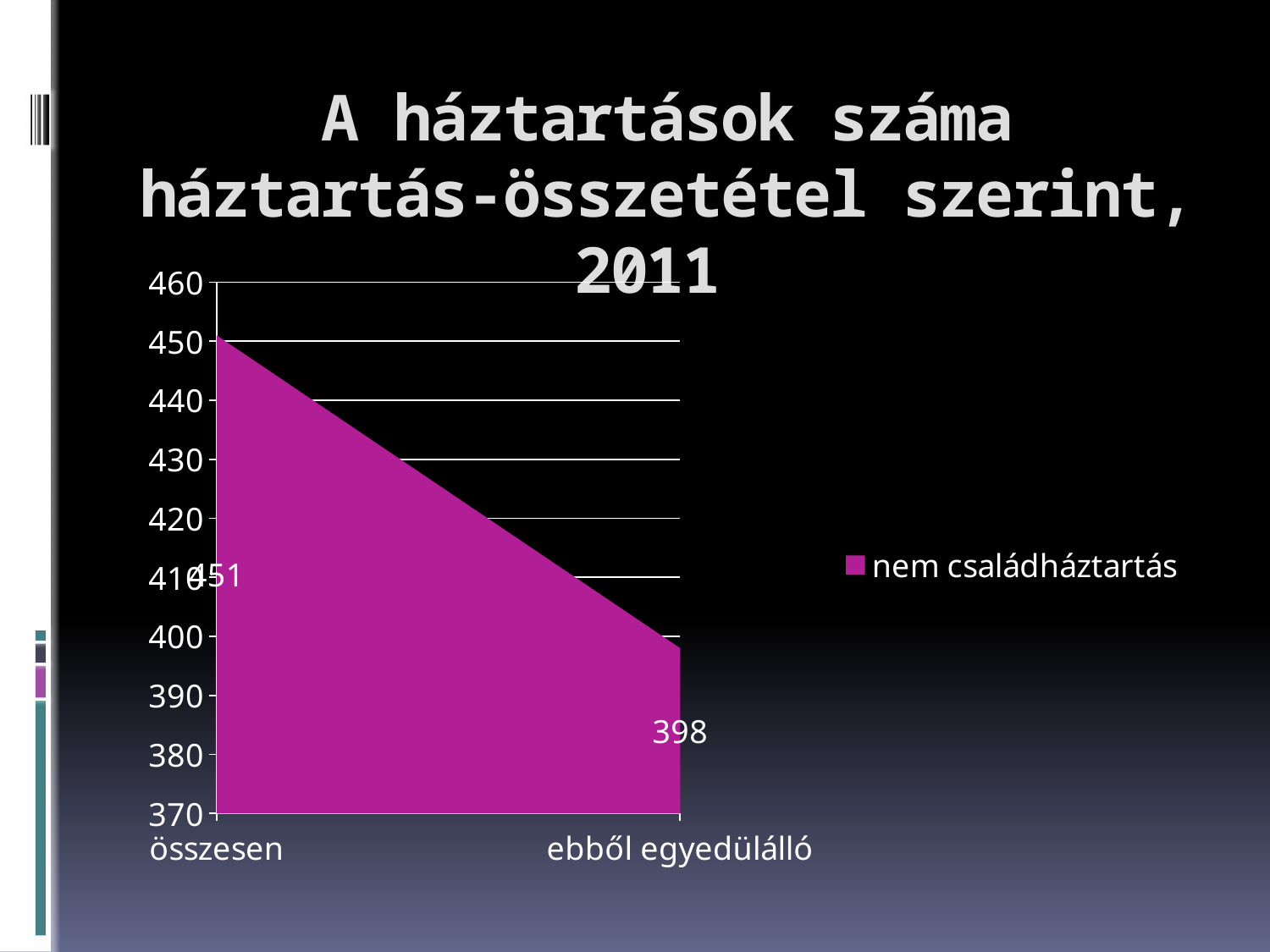
Which category has the lowest value in the chart? ebből egyedülálló How many categories are shown on the x axis of the chart? 2 What kind of chart is shown on the slide? area chart What is the value for "ebből egyedülálló" in the chart? 398 Is the value for "ebből egyedülálló" greater or less than 400? less What is the value for "összesen" in the chart? 451 What is the difference between the values for "összesen" and "ebből egyedülálló"? 53 Is the value for "összesen" greater or less than 440? greater Which category has the highest value in the chart? összesen Which is larger, the value for "összesen" or the value for "ebből egyedülálló"? összesen What series name is shown in the chart's legend? nem családháztartás How many series does the legend list? 1